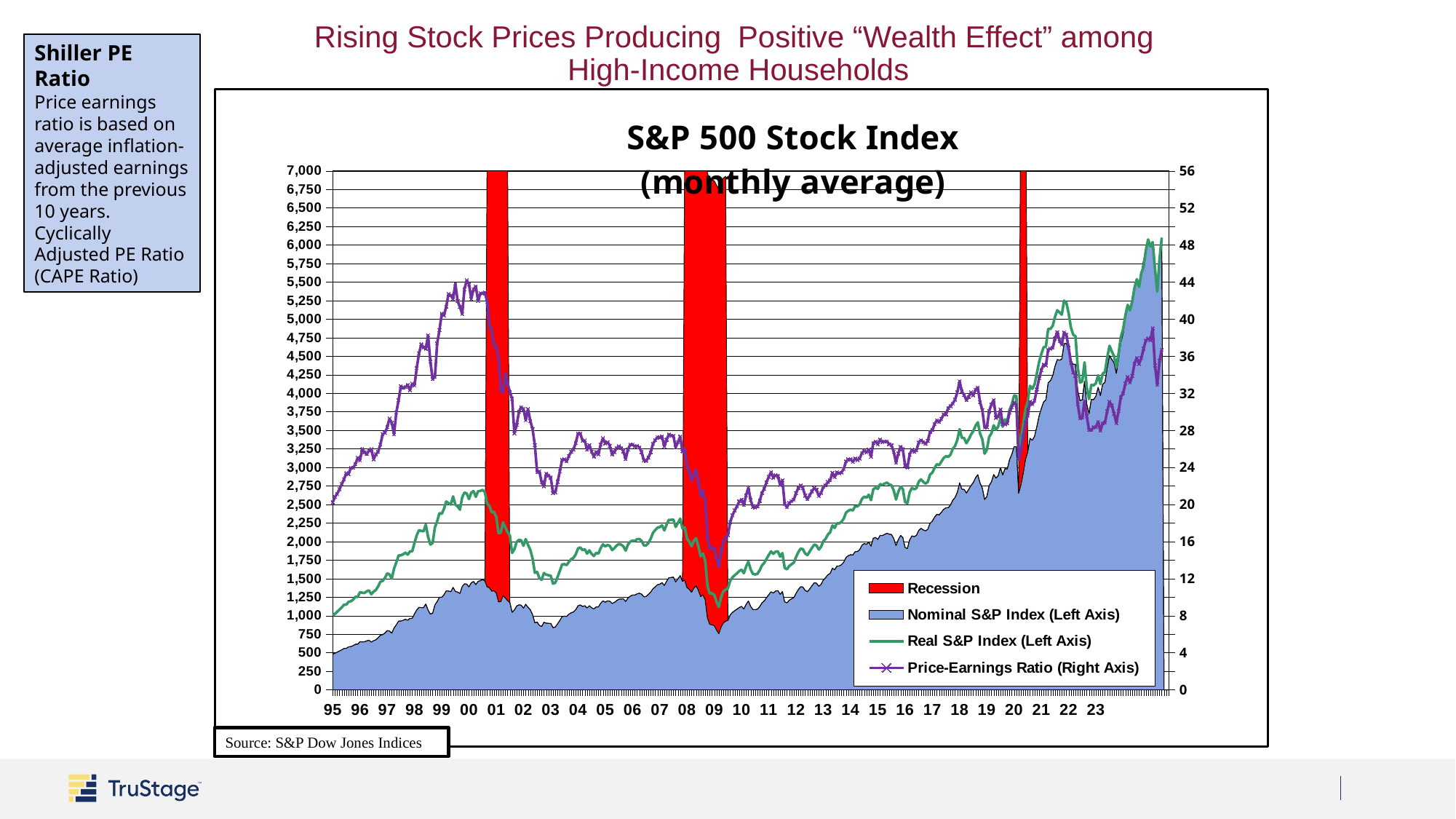
Is the Price-Earnings Ratio at its peak around 2000 greater or less than 40? greater Which series is plotted on the right axis? Price-Earnings Ratio What kind of chart is shown on the slide? combination area and line chart Is the value of the Nominal S&P Index at the start of 1995 greater or less than 1,000? less How many recession periods are shaded on the chart? 3 What is the title of the chart? S&P 500 Stock Index (monthly average) In 2010, which is higher: the Real S&P Index or the Nominal S&P Index? Real S&P Index Does the Nominal S&P Index generally rise or fall from 1995 to 2023? rise How many entries does the chart's legend list? 4 Is the value of the Nominal S&P Index at the end of 2023 greater or less than 4,000? greater